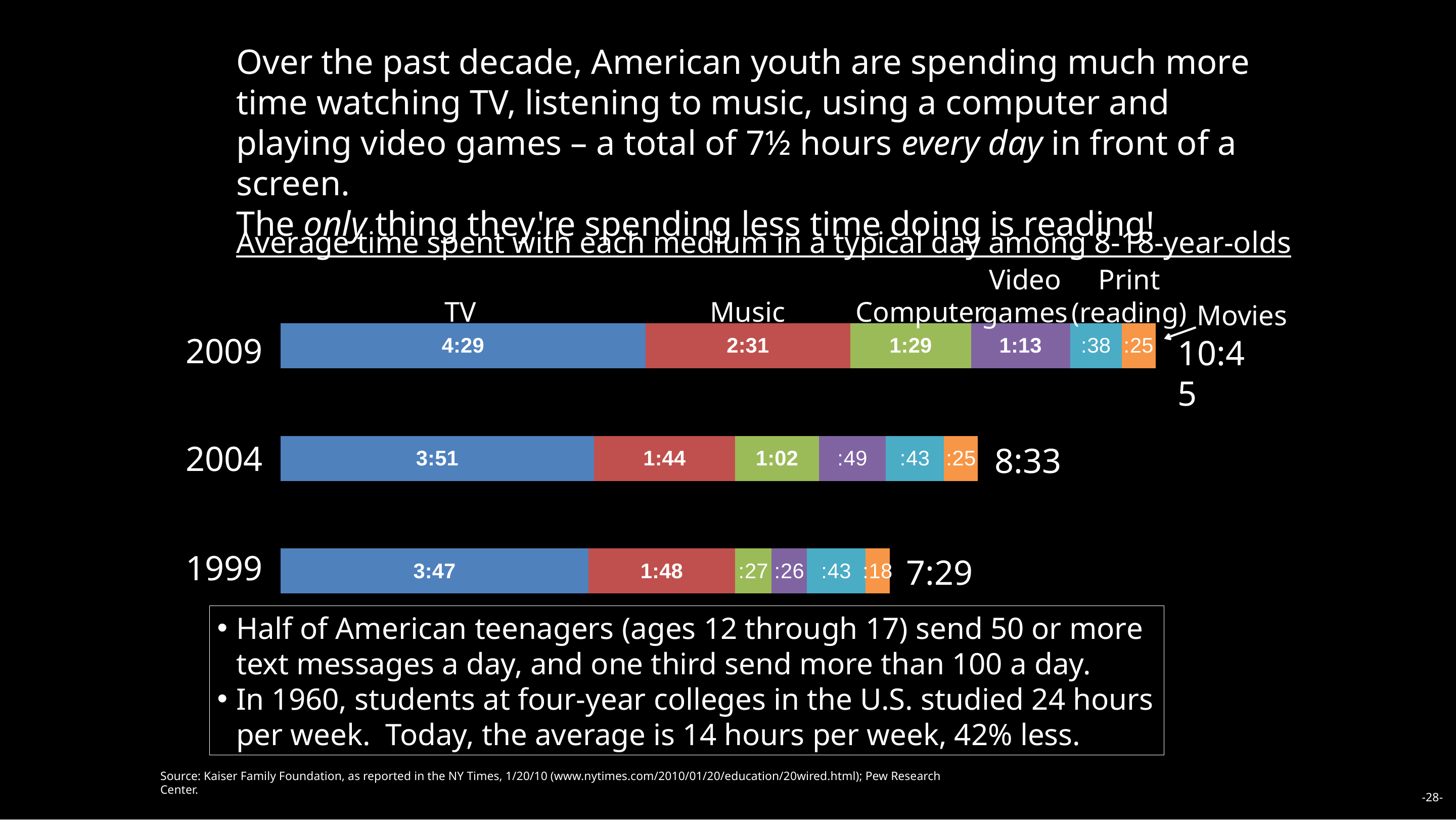
Which medium has the smallest segment in the 1999 bar? Movies What is the value for Music in 2004? 1:44 What is the total time shown at the end of the 2009 bar? 10:45 What is the value for Print (reading) in 2009? :38 How many years (bars) are shown in the chart? 3 What is the total time shown for the 1999 bar? 7:29 Is the value for Print (reading) larger in 2004 or in 2009? 2004 How many media categories make up each stacked bar? 6 What kind of chart is shown on the slide? Stacked bar chart What is the average time spent watching TV in 2009? 4:29 Which year has the largest total time spent with media? 2009 What is the value for Computer in 1999? :27